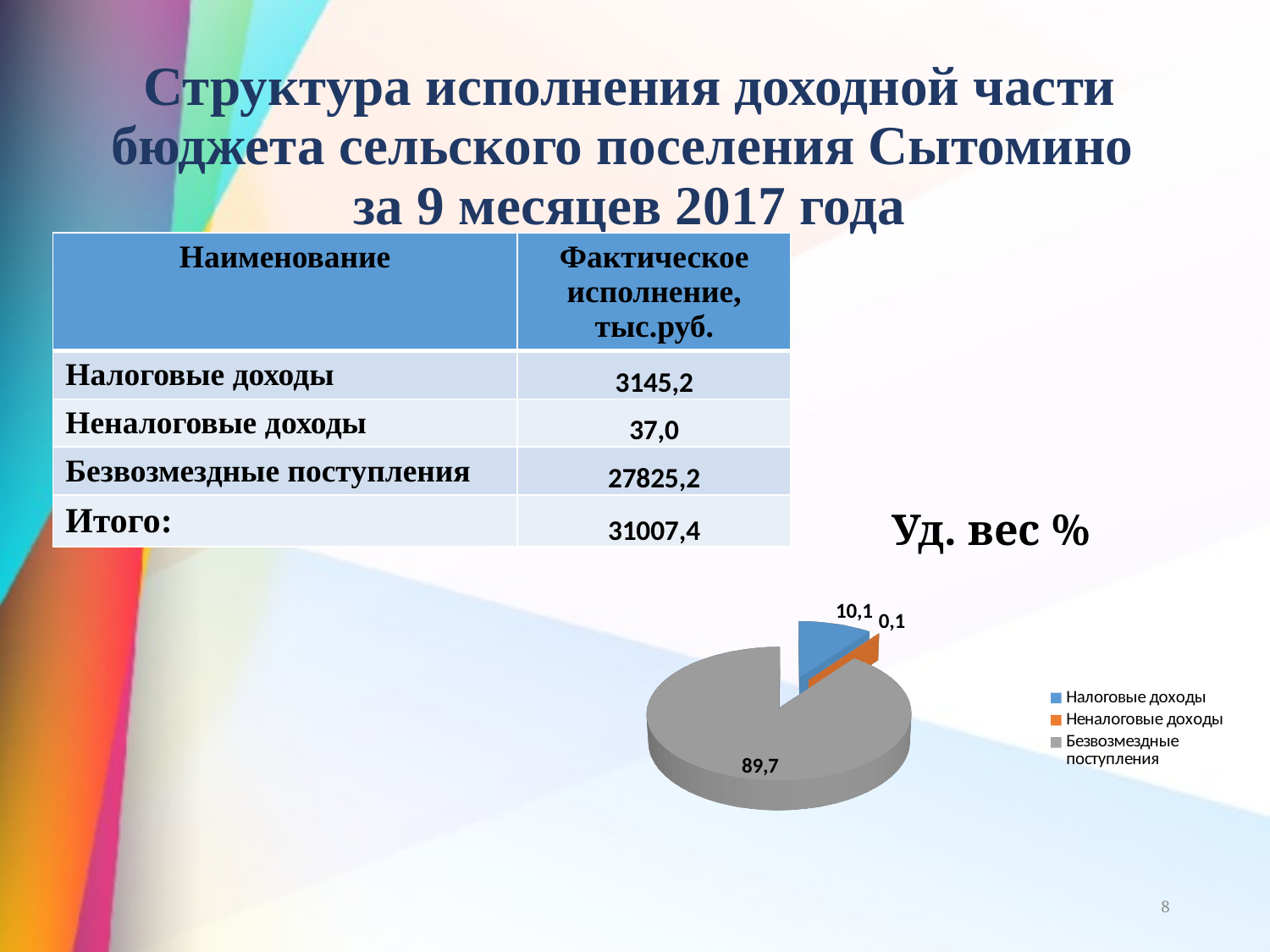
What colour is the slice for Безвозмездные поступления in the pie chart? grey What is the value shown for Безвозмездные поступления in the pie chart? 89,7 What is the difference between the values for Безвозмездные поступления and Налоговые доходы in the pie chart? 79,6 What is the value shown for Неналоговые доходы in the pie chart? 0,1 Which is larger in the pie chart: Налоговые доходы or Неналоговые доходы? Налоговые доходы What is the value shown for Налоговые доходы in the pie chart? 10,1 What is the difference between the values for Налоговые доходы and Неналоговые доходы in the pie chart? 10,0 What type of chart is shown on the slide? pie chart How many slices does the pie chart have? 3 How many entries does the legend of the pie chart list? 3 Which category has the smallest slice in the pie chart? Неналоговые доходы Which category has the largest slice in the pie chart? Безвозмездные поступления